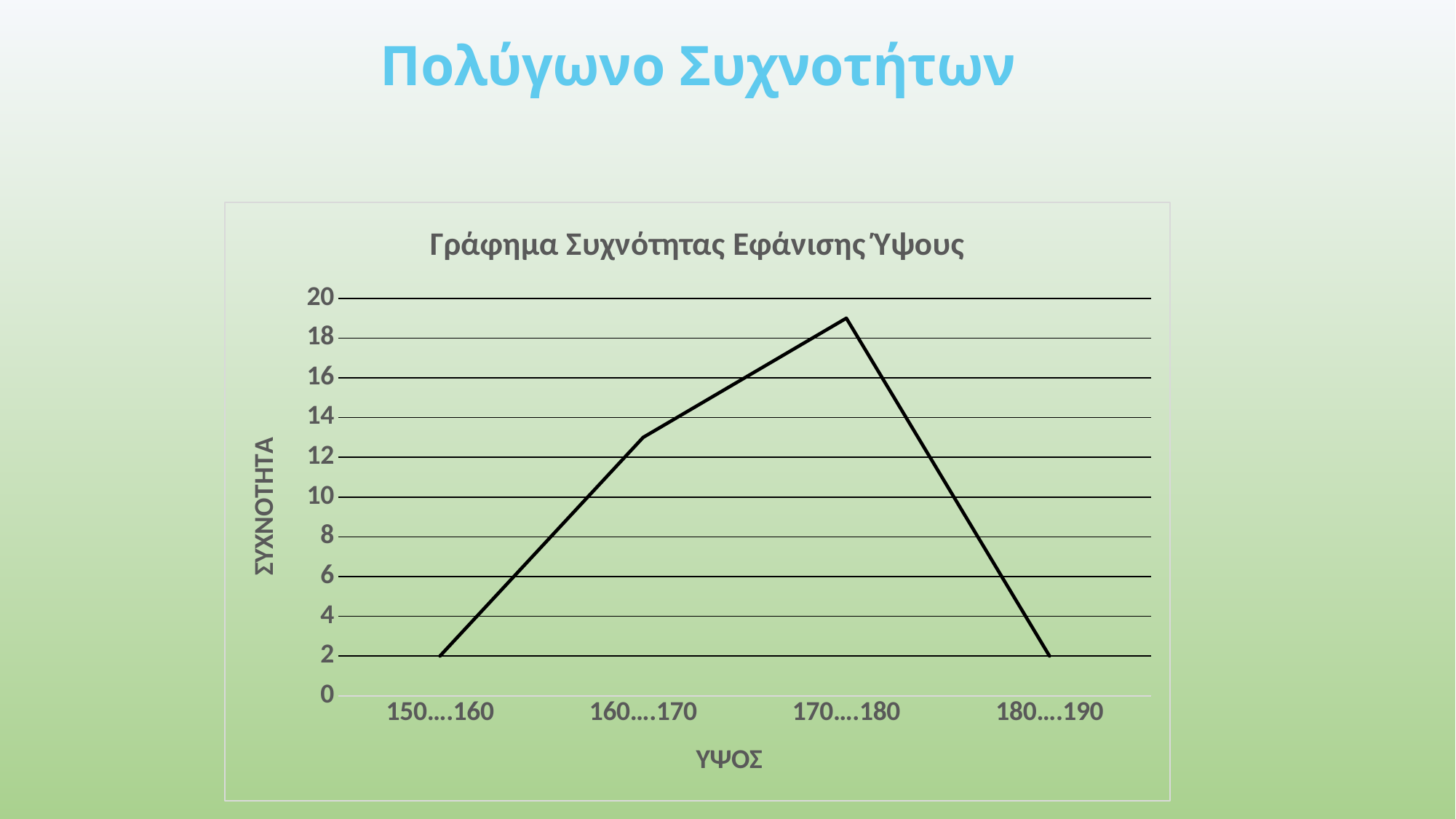
What is the frequency (ΣΥΧΝΟΤΗΤΑ) for the 150….160 category? 2 What is the frequency (ΣΥΧΝΟΤΗΤΑ) for the 180….190 category? 2 Which height category has the highest frequency? 170….180 What kind of chart is shown on the slide? line chart What is the title of the chart? Γράφημα Συχνότητας Εφάνισης Ύψους Is the frequency for 170….180 greater or less than 18? greater How many height categories are plotted on the x axis? 4 Is the frequency for 160….170 greater or less than 12? greater Does the frequency rise or fall from 170….180 to 180….190? fall Which has a higher frequency, 160….170 or 170….180? 170….180 What is the label of the x axis? ΥΨΟΣ Is the frequency for 160….170 greater or less than 14? less